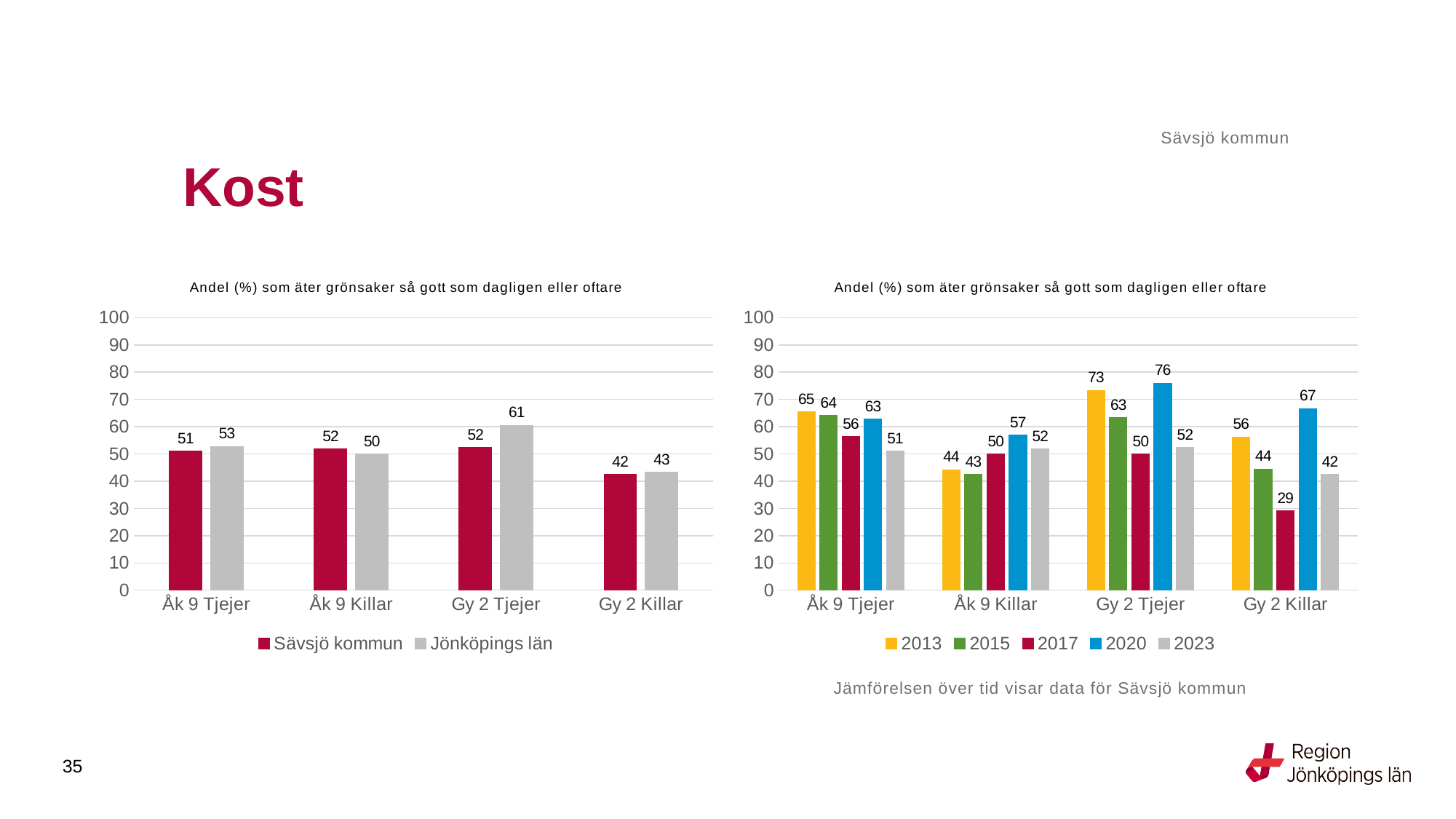
In the left chart, how many series does the legend list? 2 In the right chart, how many series does the legend list? 5 What type of chart is the right chart? Bar chart In the left chart, what is the value for Jönköpings län for Gy 2 Tjejer? 61 In the left chart, what is the value for Sävsjö kommun for Gy 2 Tjejer? 52 In the right chart, what is the value for 2017 for Gy 2 Killar? 29 In the right chart, which year has the highest value for Gy 2 Killar? 2020 In the left chart, which category has the lowest value for Sävsjö kommun? Gy 2 Killar In the right chart, which is larger for Åk 9 Killar: the value for 2013 or the value for 2020? 2020 In the left chart, what is the difference between Jönköpings län and Sävsjö kommun for Gy 2 Tjejer? 9 In the right chart, what is the difference between the 2013 and 2023 values for Åk 9 Tjejer? 14 In the right chart, what is the value for 2020 for Gy 2 Tjejer? 76